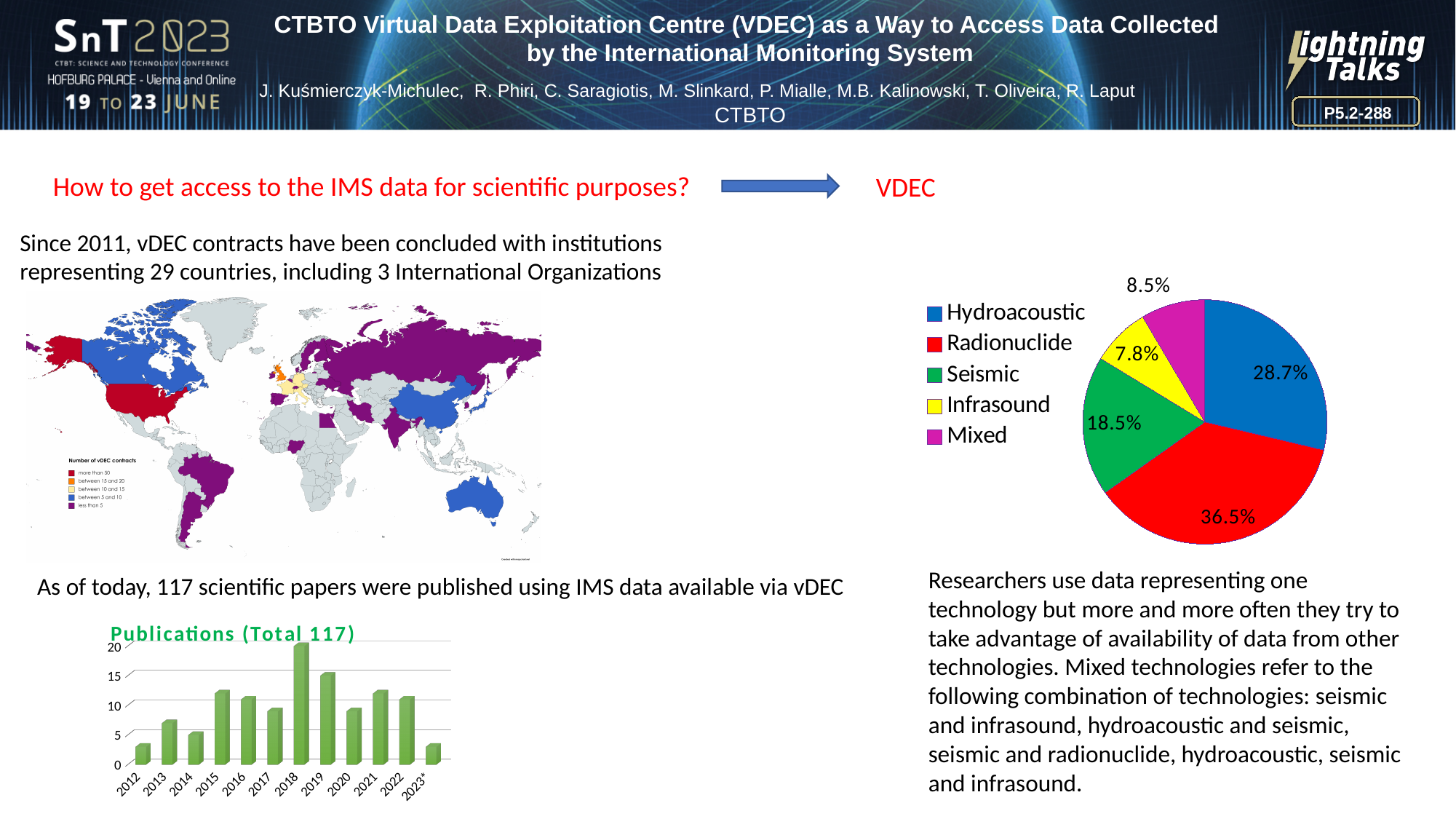
How many entries does the legend of the pie chart list? 5 In the pie chart, what share does Infrasound have? 7.8% In the pie chart, what is the difference between the Hydroacoustic and Seismic shares? 10.2% How many years are shown on the x axis of the 'Publications (Total 117)' chart? 12 In the pie chart, which technology has the smallest share? Infrasound In the pie chart, what share does Seismic have? 18.5% In the 'Publications (Total 117)' chart, which year has the highest number of publications? 2018 In the pie chart, which colour represents Mixed? Magenta In the pie chart, which technology has the largest share? Radionuclide In the 'Publications (Total 117)' chart, is the value for 2015 greater or less than 10? greater What type of chart is the 'Publications (Total 117)' chart? Bar chart In the pie chart, what share does Radionuclide have? 36.5%